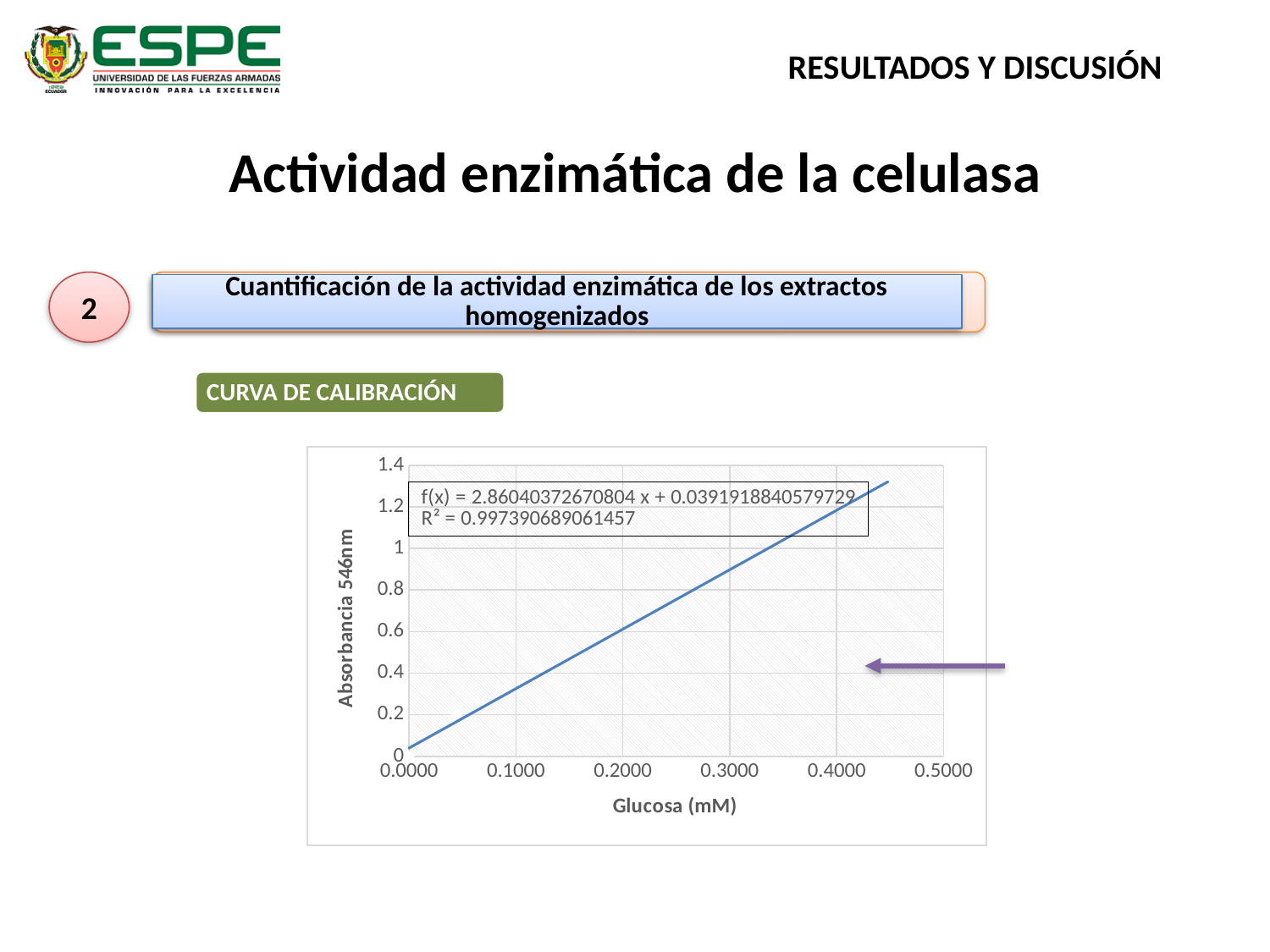
What is the slope of the fitted line f(x) shown on the calibration curve chart? 2.86040372670804 Is the absorbance at a glucose concentration of 0.4000 mM greater or less than 1? greater What is the intercept of the fitted line f(x) shown on the calibration curve chart? 0.0391918840579729 Does the absorbance rise or fall as glucose concentration increases along the x axis? rise What is the highest tick value shown on the y axis of the calibration curve chart? 1.4 What is the highest tick value shown on the x axis of the calibration curve chart? 0.5000 What is the label of the y axis of the calibration curve chart? Absorbancia 546nm Is the absorbance at a glucose concentration of 0.3000 mM greater or less than 0.8? greater What kind of chart is shown under 'CURVA DE CALIBRACIÓN'? line chart What is the label of the x axis of the calibration curve chart? Glucosa (mM) What is the R² value shown on the calibration curve chart? 0.997390689061457 Is the absorbance at a glucose concentration of 0.1000 mM greater or less than 0.4? less